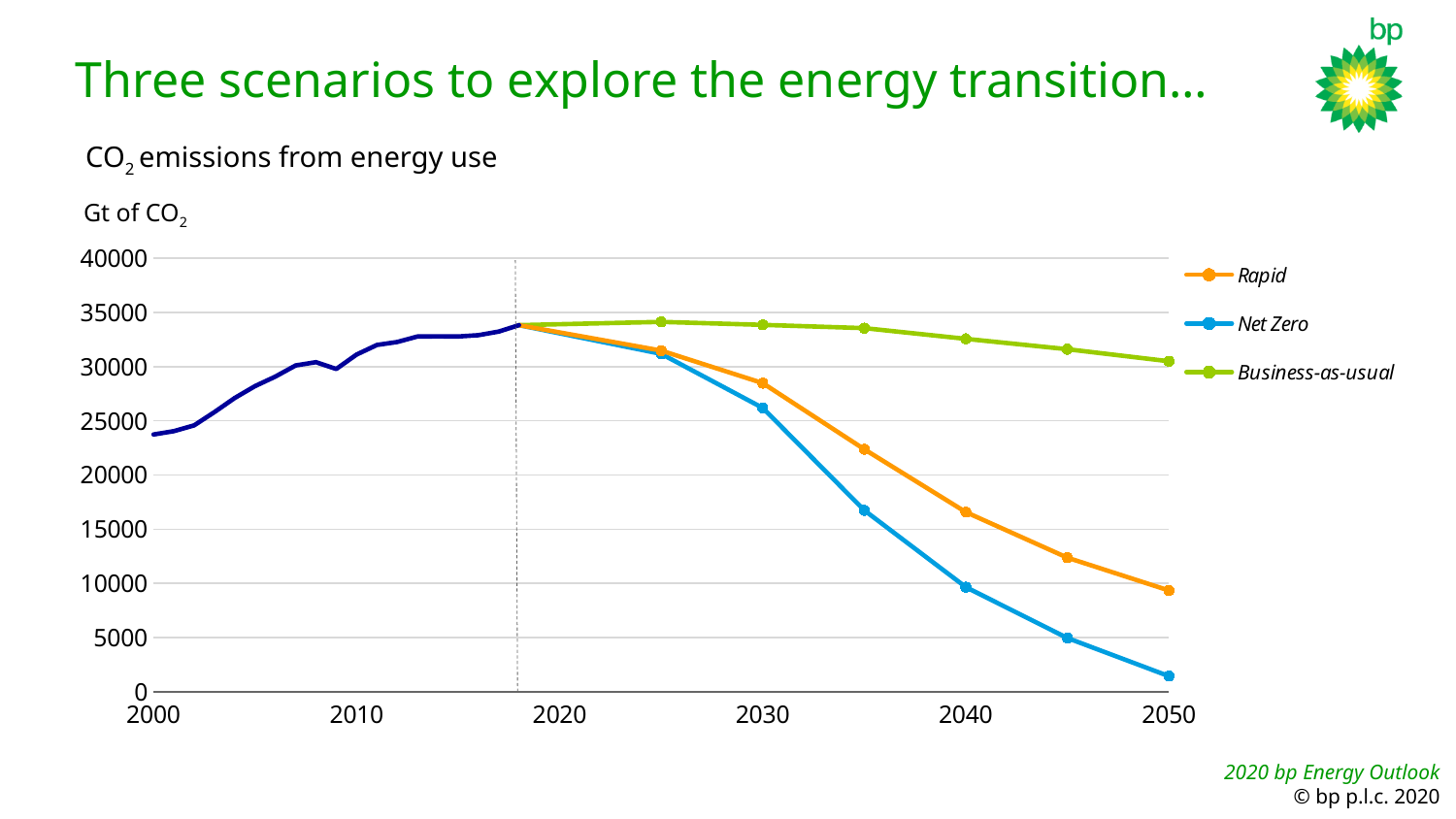
In 2040, which is larger: the value for Rapid or the value for Net Zero? Rapid Is the value for Net Zero in 2050 greater or less than 5000? less Which scenario has the highest value in 2050? Business-as-usual Does the Net Zero line rise or fall between 2020 and 2050? fall Is the value for Business-as-usual in 2050 greater or less than 30000? greater Is the value for Rapid in 2050 greater or less than 10000? less What kind of chart is shown on the slide? line chart What unit is given for the y axis of the chart? Gt of CO2 How many series does the legend list? 3 Which scenario has the lowest value in 2050? Net Zero